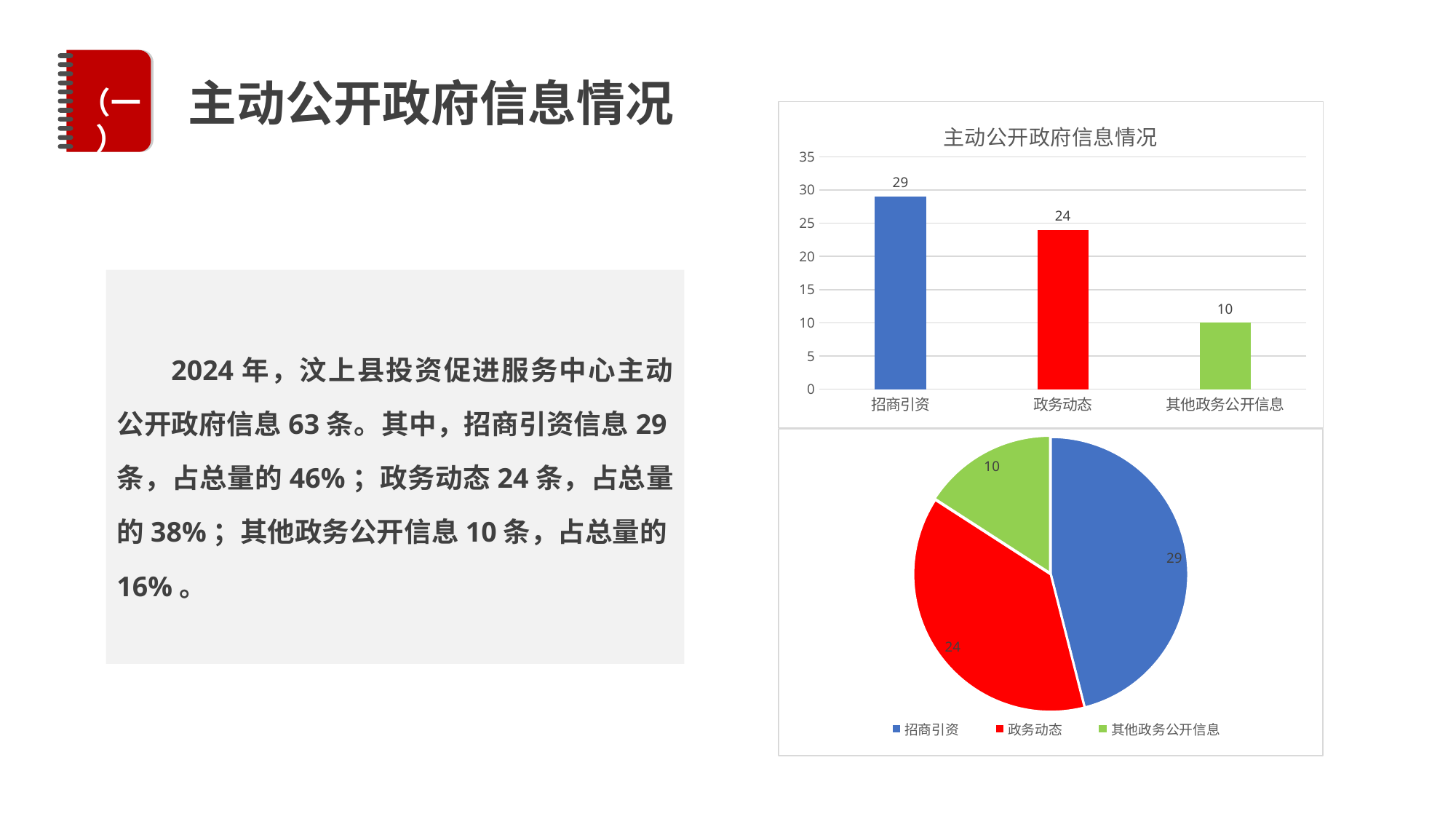
In the bar chart titled 主动公开政府信息情况, what is the value for 其他政务公开信息? 10 In the bar chart titled 主动公开政府信息情况, do the values rise or fall from left to right along the x axis? fall In the bar chart titled 主动公开政府信息情况, what is the difference between the values for 招商引资 and 政务动态? 5 In the bar chart titled 主动公开政府信息情况, how many categories are shown on the x axis? 3 In the bar chart titled 主动公开政府信息情况, which category has the lowest value? 其他政务公开信息 In the bar chart titled 主动公开政府信息情况, which is larger, the value for 政务动态 or the value for 其他政务公开信息? 政务动态 In the bar chart titled 主动公开政府信息情况, what is the value for 政务动态? 24 In the pie chart at the bottom right of the slide, how many entries does the legend list? 3 In the bar chart titled 主动公开政府信息情况, which category has the highest value? 招商引资 In the bar chart titled 主动公开政府信息情况, what is the value for 招商引资? 29 In the pie chart at the bottom right of the slide, what colour is the slice for 政务动态? red What kind of chart is the upper chart on the right side of the slide? bar chart